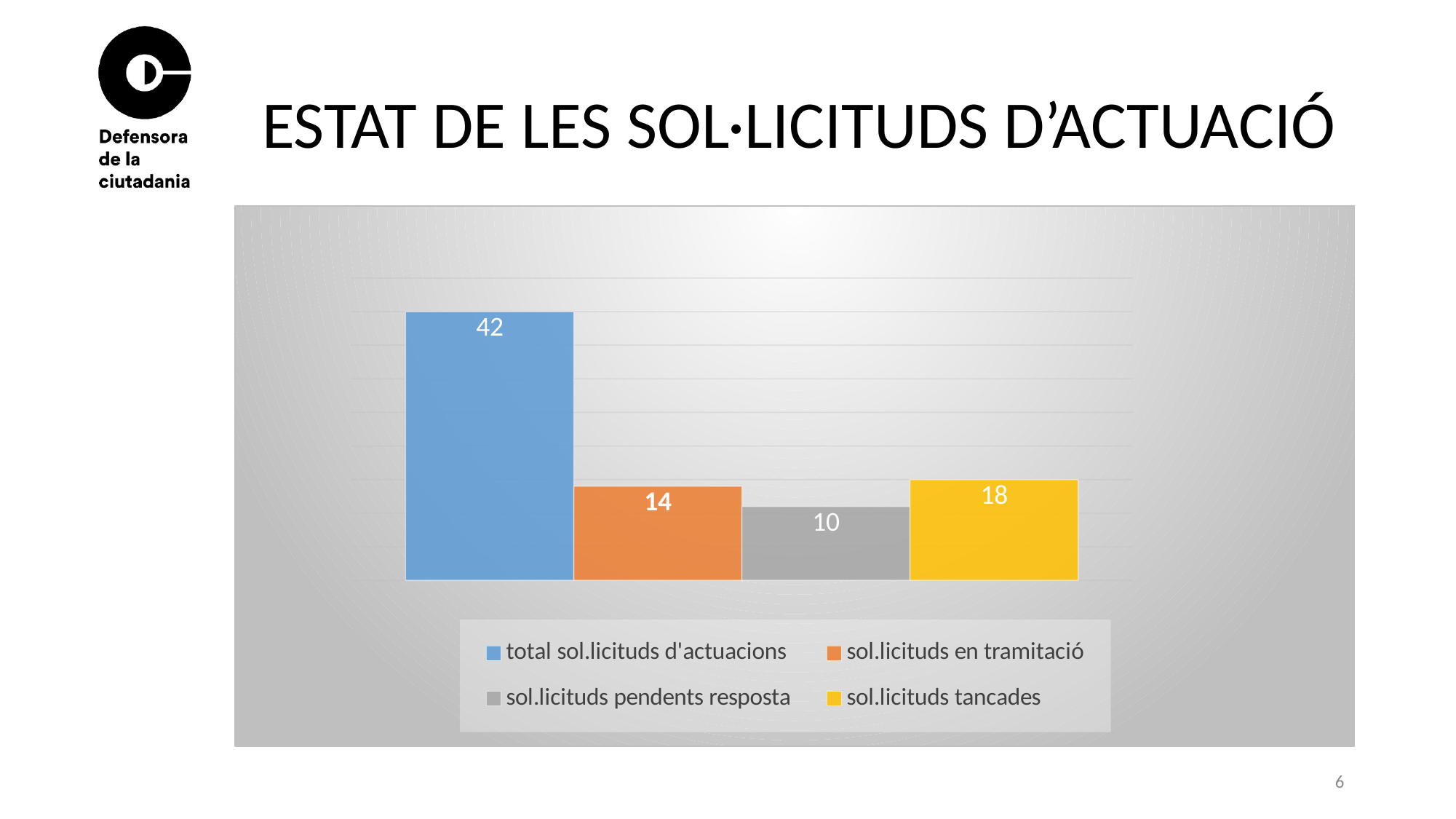
How many series does the legend list? 4 What is the value for total sol.licituds d'actuacions? 42 What kind of chart is shown on the slide? bar chart What is the difference between total sol.licituds d'actuacions and sol.licituds tancades? 24 What colour is the bar for sol.licituds tancades? yellow What is the difference between sol.licituds tancades and sol.licituds en tramitació? 4 What is the value for sol.licituds tancades? 18 Which series has the highest value? total sol.licituds d'actuacions Which is larger, sol.licituds en tramitació or sol.licituds tancades? sol.licituds tancades Which series has the lowest value? sol.licituds pendents resposta What is the value for sol.licituds en tramitació? 14 What is the value for sol.licituds pendents resposta? 10